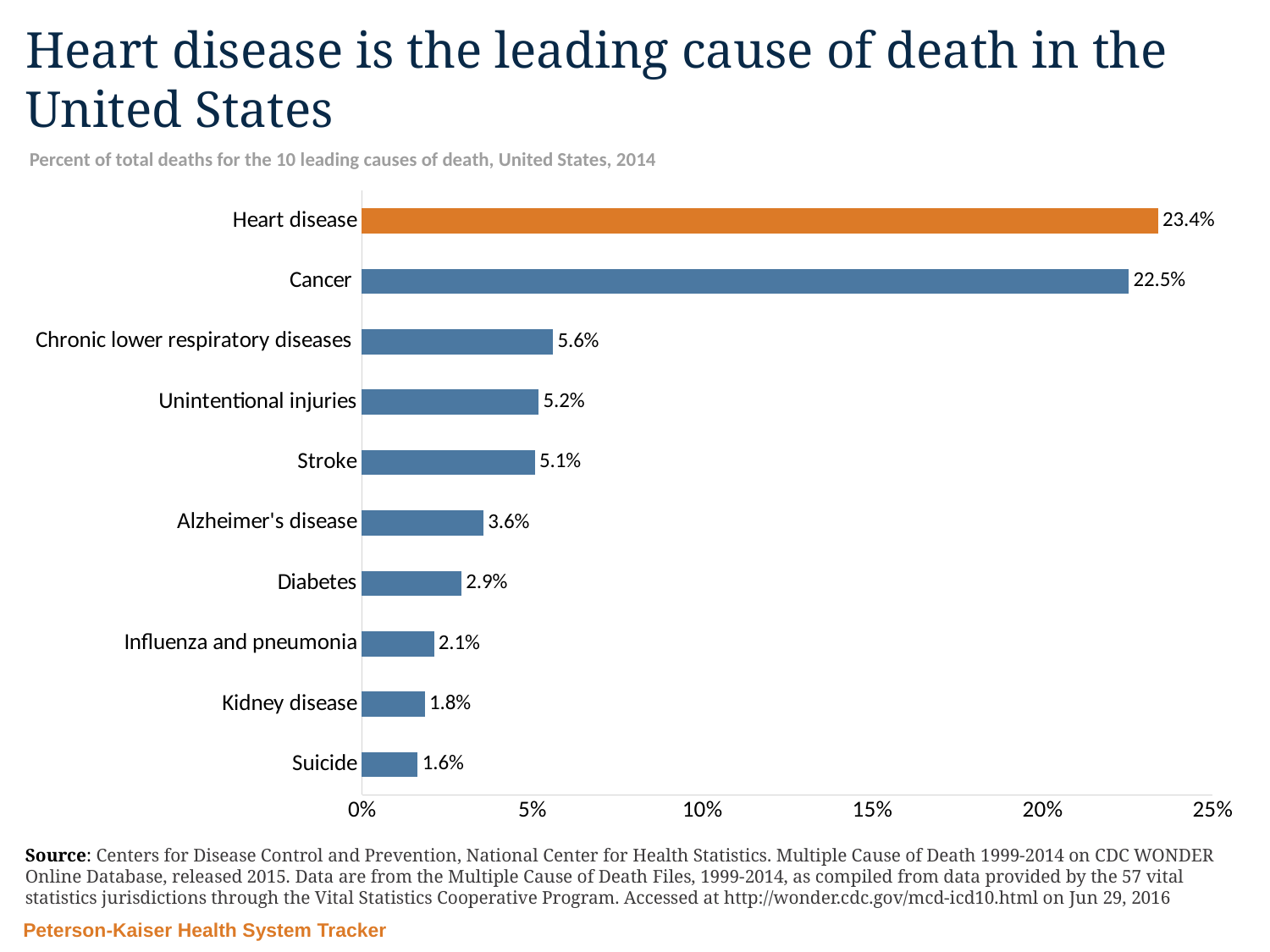
What is the difference between the values for Heart disease and Cancer? 0.9% What is the value shown for Influenza and pneumonia? 2.1% Which has a larger share of total deaths, Diabetes or Kidney disease? Diabetes What is the difference between the values for Chronic lower respiratory diseases and Stroke? 0.5% Which cause of death has the lowest percent of total deaths? Suicide What percent of total deaths is attributed to heart disease? 23.4% What kind of chart is shown on the slide? Bar chart How many causes of death are shown in the chart? 10 What is the value shown for Cancer? 22.5% Which bar is shown in a different colour (orange) from the others? Heart disease What percent of total deaths is shown for Alzheimer's disease? 3.6% Which cause of death has the highest percent of total deaths? Heart disease